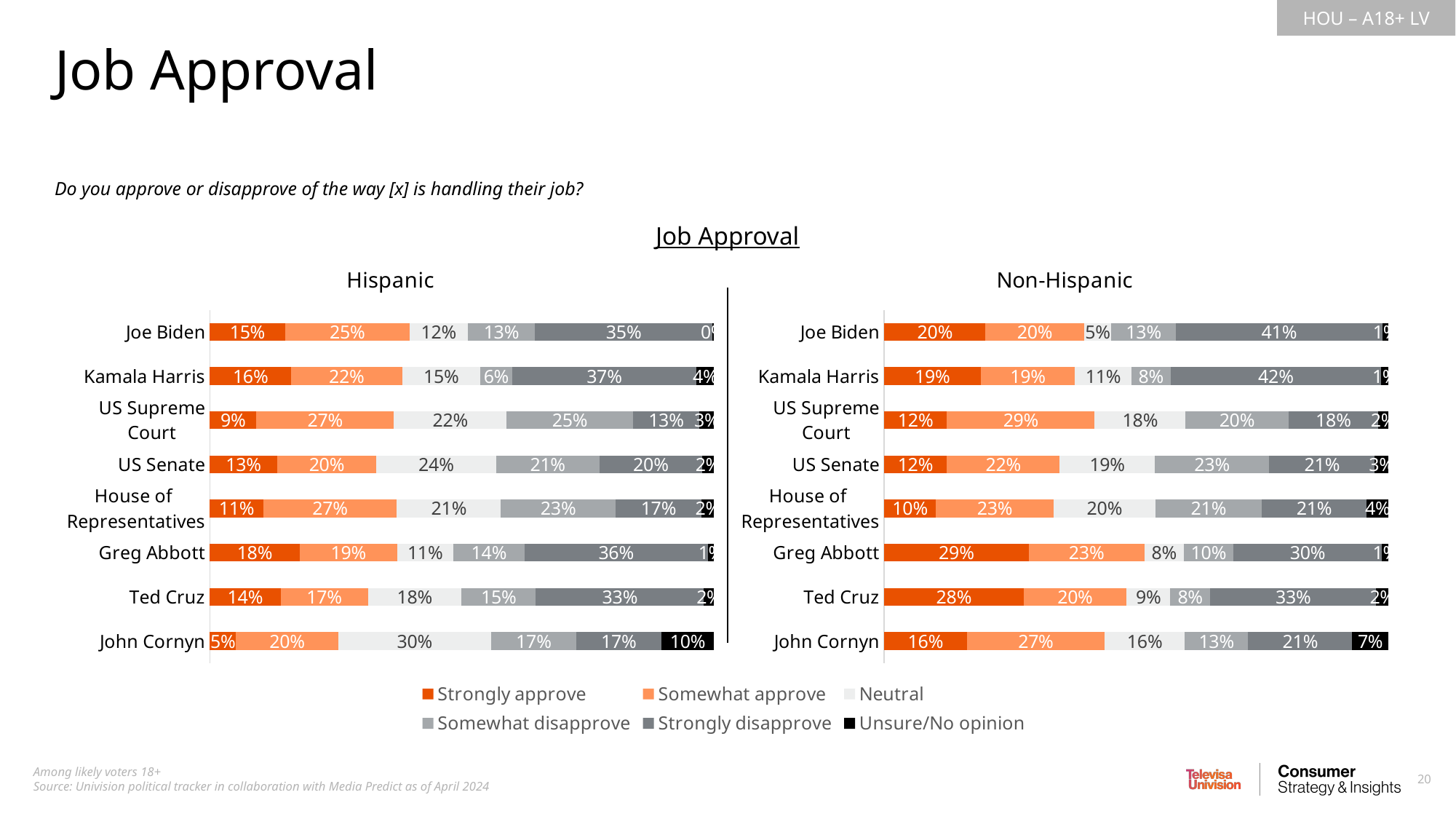
How many series does the legend list? 6 In the Hispanic chart, what percentage strongly disapprove of Joe Biden? 35% In the Non-Hispanic chart, which person or institution has the highest Strongly disapprove value? Kamala Harris In the Non-Hispanic chart, what percentage strongly approve of Greg Abbott? 29% In the Non-Hispanic chart, what is the Unsure/No opinion value for John Cornyn? 7% Which legend entry is shown in black? Unsure/No opinion What type of chart is used for the Non-Hispanic data? Stacked bar chart Is the Strongly approve value for Ted Cruz higher in the Hispanic chart or the Non-Hispanic chart? Non-Hispanic In the Hispanic chart, what is the Neutral value for John Cornyn? 30% In the Hispanic chart, which person or institution has the lowest Strongly approve value? John Cornyn In the Hispanic chart, what is the difference between the Somewhat approve values for the US Supreme Court and Ted Cruz? 10% How many people or institutions are listed in the Hispanic chart? 8